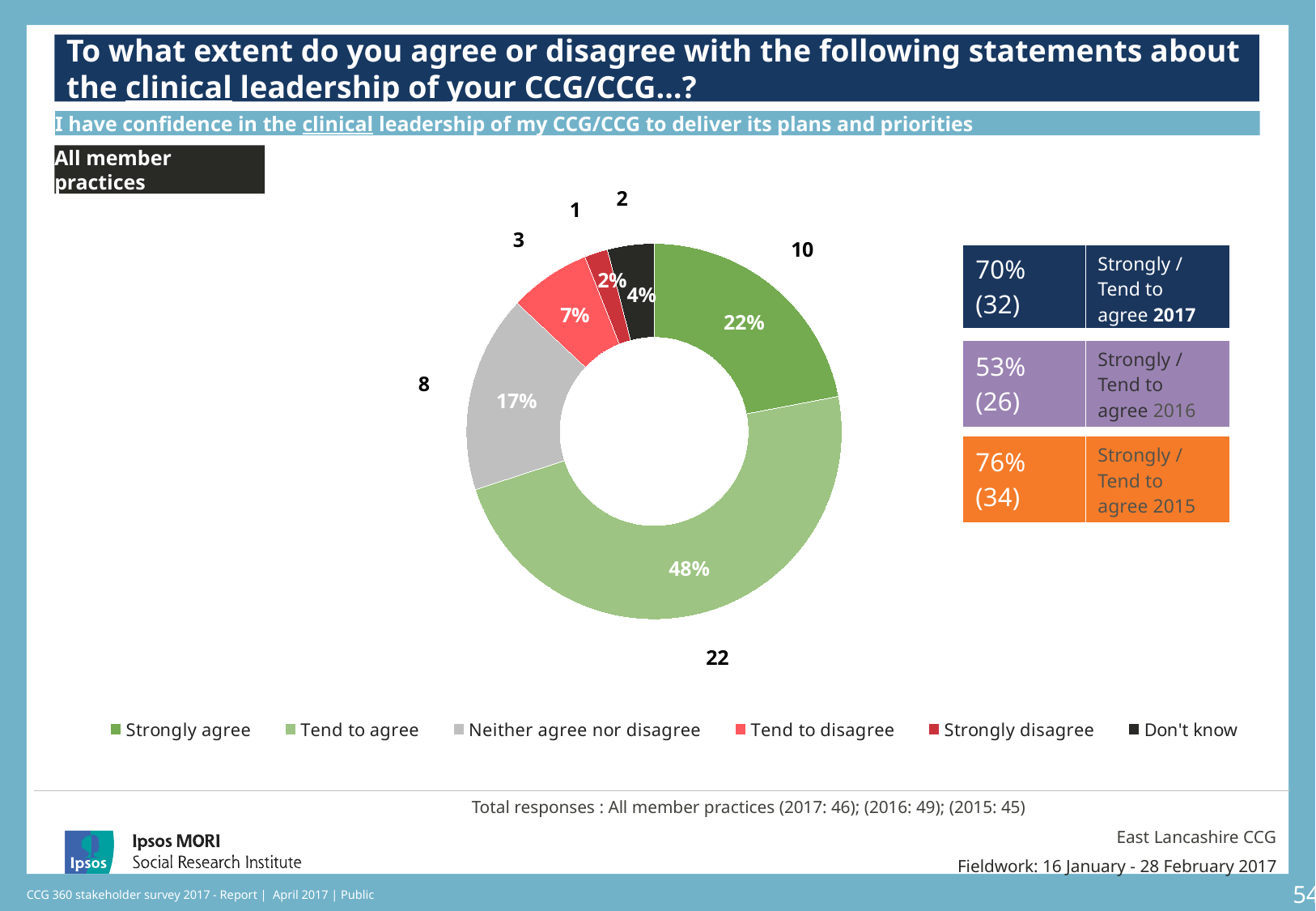
How many response categories does the legend list? 6 What percentage of respondents said they tend to agree? 48% What kind of chart is shown on the slide? Donut (pie) chart What was the combined 'Strongly / Tend to agree' percentage in 2016? 53% What percentage of respondents said they strongly agree? 22% Which response category has the smallest share of the donut chart? Strongly disagree Which response category has the largest share of the donut chart? Tend to agree What is the difference in percentage points between 'Tend to agree' and 'Strongly agree'? 26 What is the total number of responses from all member practices in 2017? 46 Which is larger: the share for 'Neither agree nor disagree' or the share for 'Tend to disagree'? Neither agree nor disagree How many respondents said they neither agree nor disagree? 8 What percentage of respondents answered 'Don't know'? 4%